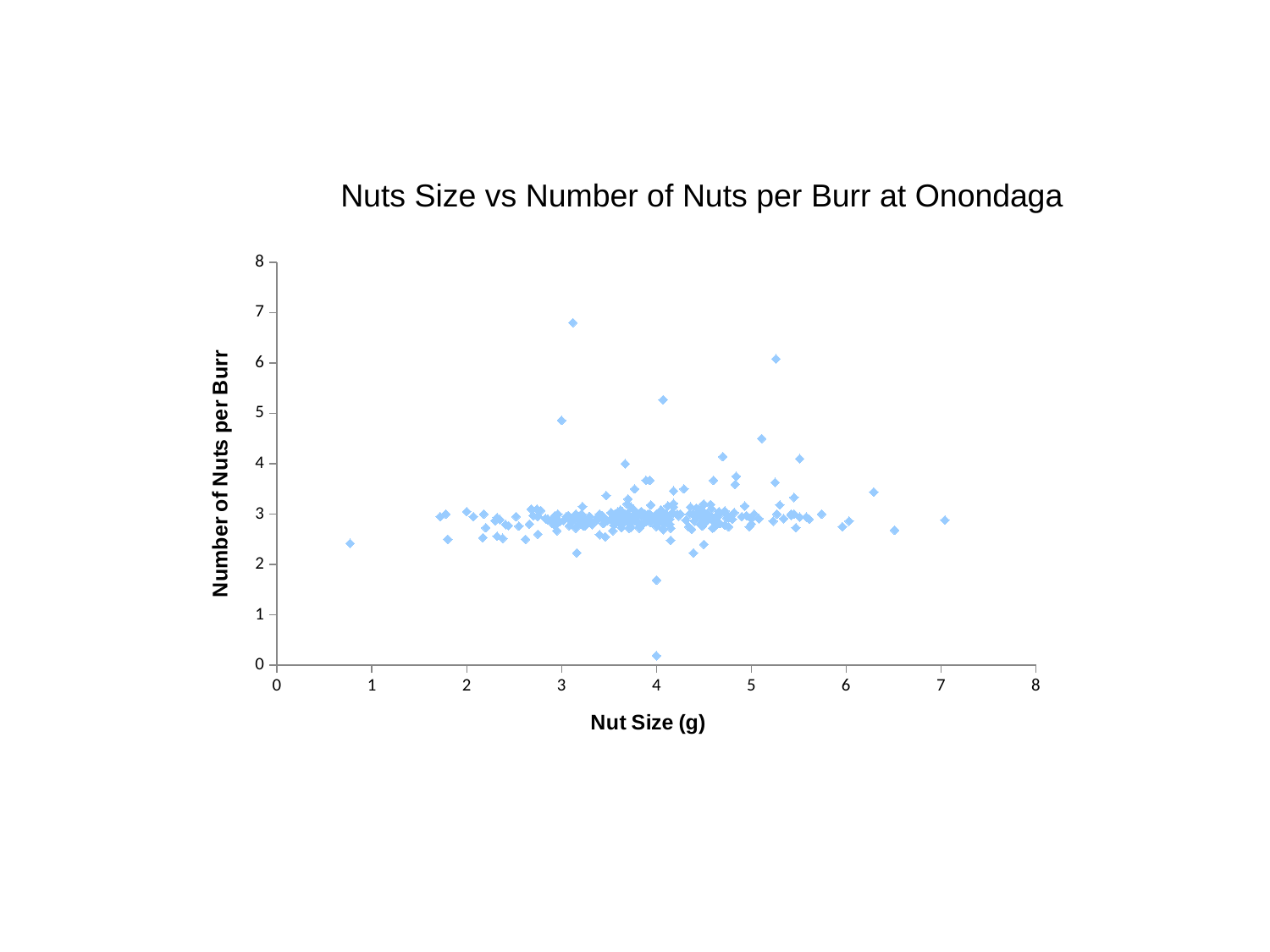
What is the label of the x axis? Nut Size (g) What is the title of the chart? Nuts Size vs Number of Nuts per Burr at Onondaga Are the number of nuts per burr values for most of the points greater or less than 2? greater Is the number of nuts per burr for the highest point on the chart greater or less than 6? greater Is the point with the largest number of nuts per burr located at a nut size greater or less than 4? less As nut size increases along the x axis, does the number of nuts per burr generally rise, fall, or stay roughly flat? roughly flat What kind of chart is shown on the slide? Scatter plot